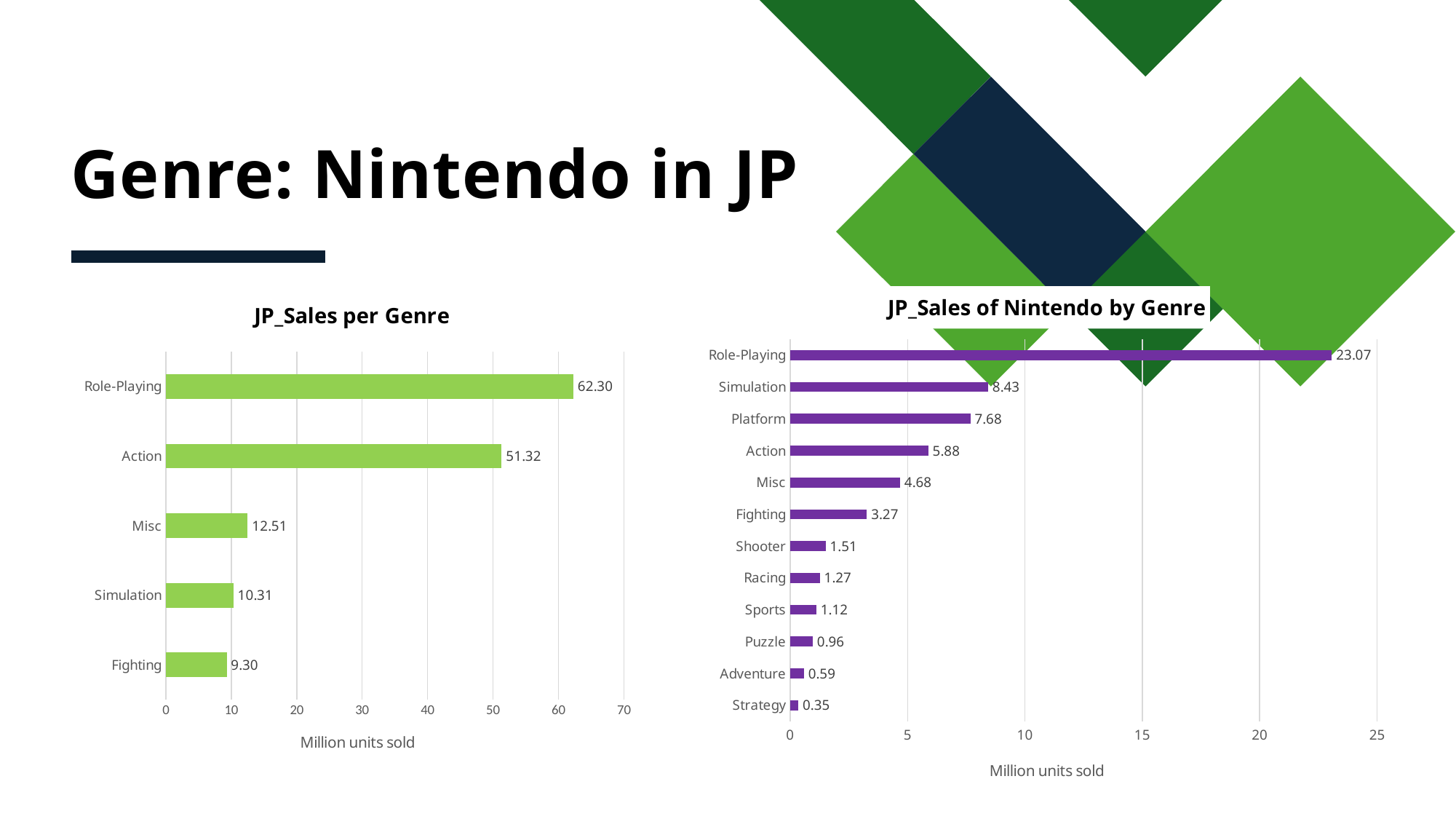
In the 'JP_Sales of Nintendo by Genre' chart, what is the value for Platform? 7.68 In the 'JP_Sales per Genre' chart, which genre has the lowest value? Fighting In the 'JP_Sales per Genre' chart, which genre has the highest value? Role-Playing In the 'JP_Sales of Nintendo by Genre' chart, how many genres are shown? 12 In the 'JP_Sales of Nintendo by Genre' chart, which genre has the highest value? Role-Playing In the 'JP_Sales of Nintendo by Genre' chart, which is larger, Simulation or Platform? Simulation In the 'JP_Sales of Nintendo by Genre' chart, what is the value for Strategy? 0.35 In the 'JP_Sales per Genre' chart, what is the difference between Role-Playing and Action? 10.98 In the 'JP_Sales of Nintendo by Genre' chart, what is the difference between Action and Misc? 1.20 In the 'JP_Sales per Genre' chart, how many genres are shown? 5 What type of chart is the 'JP_Sales per Genre' chart? Bar chart In the 'JP_Sales per Genre' chart, what is the value for Action? 51.32